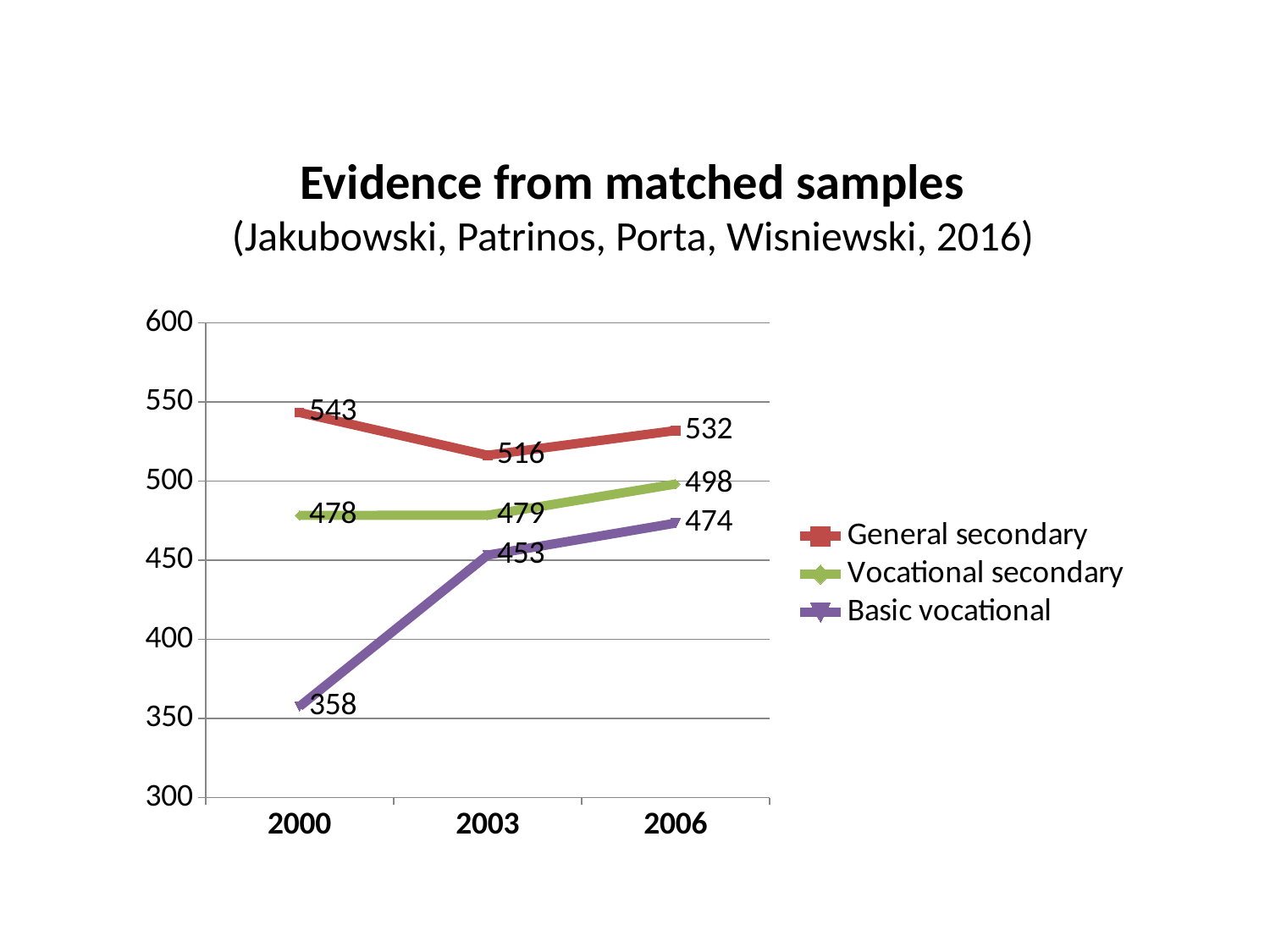
What is the value for Basic vocational in 2003? 453 What kind of chart is shown on the slide? Line chart Which is larger in 2006, Vocational secondary or Basic vocational? Vocational secondary How many series does the legend list? 3 In which year is the General secondary value highest? 2000 In which year is the Basic vocational value lowest? 2000 What is the value for Vocational secondary in 2006? 498 What is the value for General secondary in 2000? 543 How many years are shown on the x axis? 3 What is the difference between General secondary and Vocational secondary in 2003? 37 Does the Basic vocational series rise or fall from 2000 to 2006? Rise What is the difference between the Basic vocational values in 2006 and 2000? 116